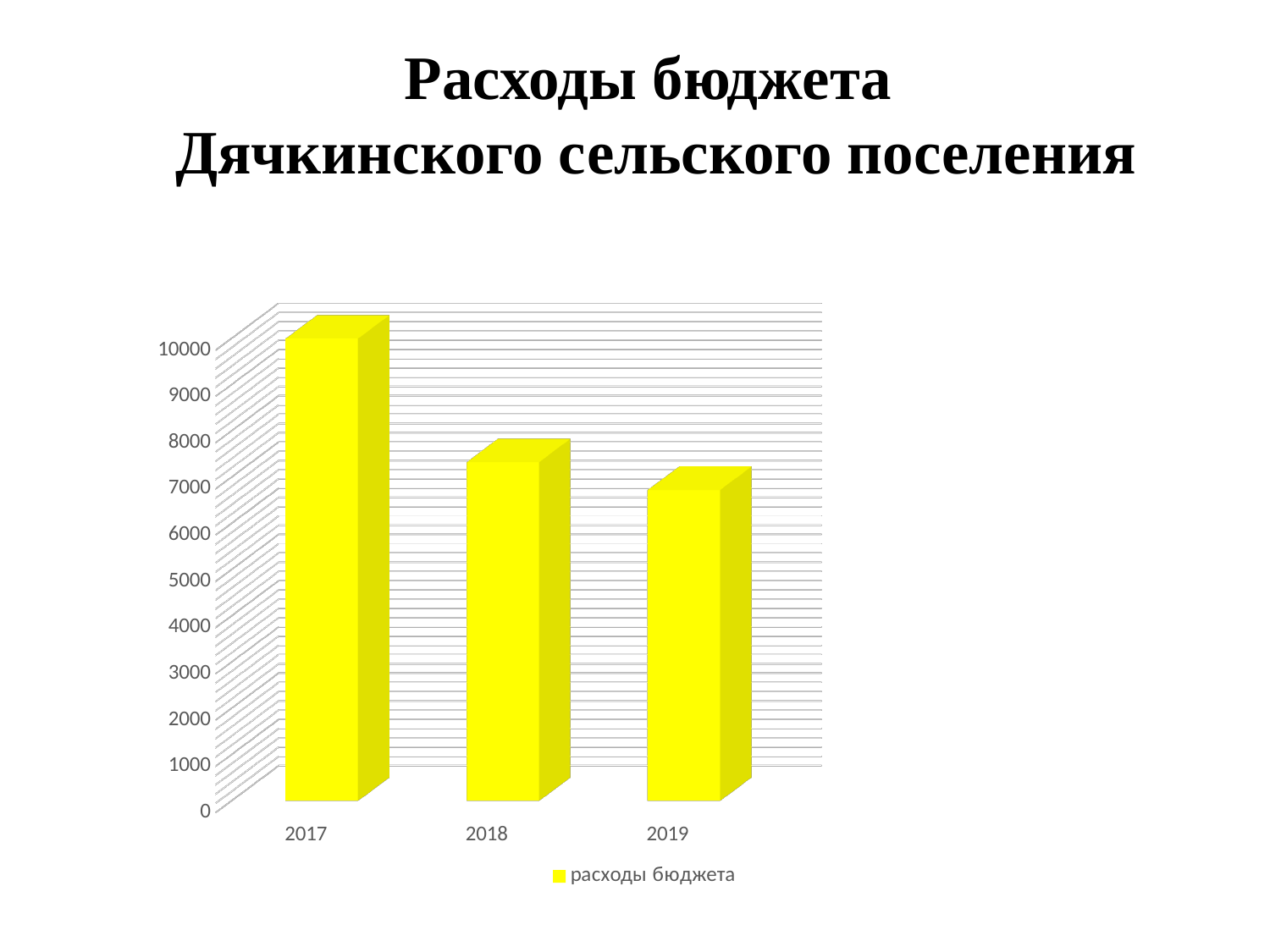
Is the value for 2018 greater or less than 8000? less How many years are shown on the x axis of the chart? 3 Which year has the highest budget expenditure in the chart? 2017 What kind of chart is shown on the slide? bar chart Is the value for 2019 greater or less than 6000? greater Which year has the lowest budget expenditure in the chart? 2019 What is the name of the series shown in the chart legend? расходы бюджета Which is larger, the value for 2018 or the value for 2019? 2018 What colour are the bars in the chart? yellow Do the values rise or fall from 2017 to 2019? fall How many series does the chart legend list? 1 Is the value for 2017 greater or less than 9000? greater